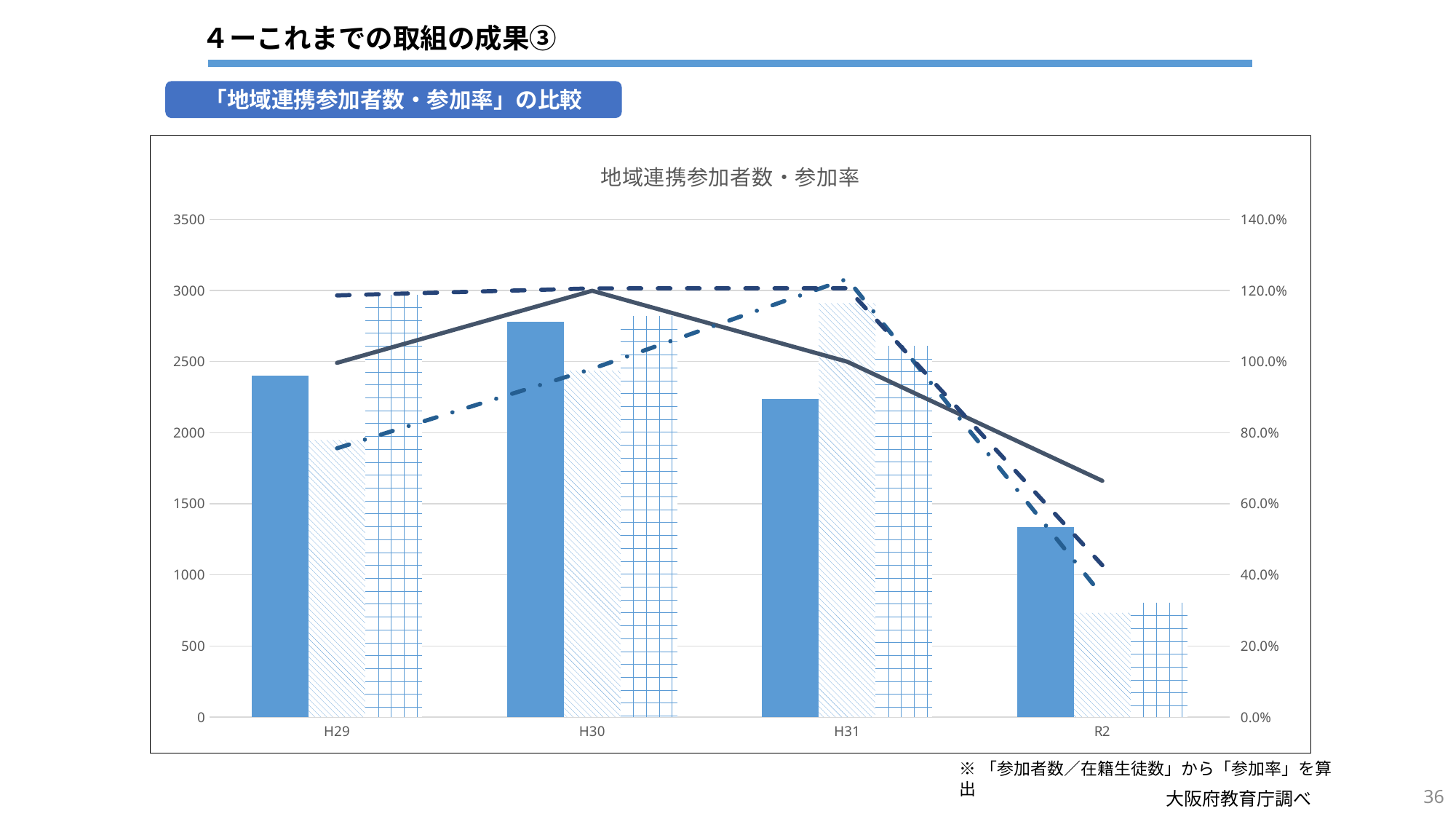
Is the value of the solid line at R2 greater or less than 80.0%? less Is the value of the solid blue bar for H29 greater or less than 2000? greater Is the value of the solid blue bar for R2 greater or less than 1500? less What is the title of the chart? 地域連携参加者数・参加率 Which category has the shortest solid blue bar? R2 How many categories are shown on the x axis of the chart? 4 What kind of chart is shown on the slide? A combined bar and line chart Which category has the tallest solid blue bar? H30 Which is larger, the solid blue bar for H29 or the solid blue bar for H31? H29 Does the solid line rise or fall from H31 to R2? fall What is the highest tick label on the right-hand axis? 140.0%